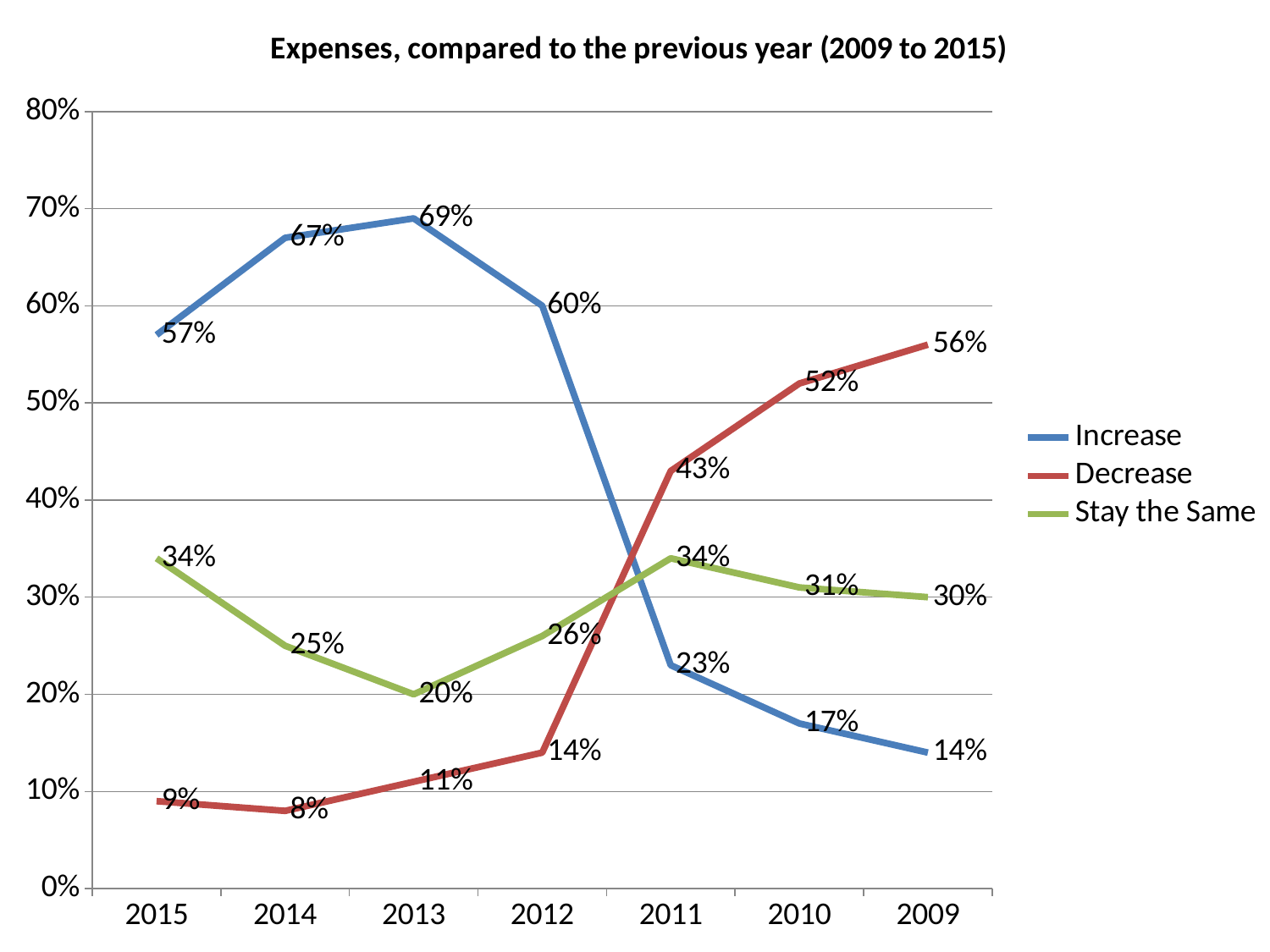
What is the value for Increase in 2013? 69% How many series does the legend list? 3 How many years are shown on the x axis? 7 What is the title of the chart? Expenses, compared to the previous year (2009 to 2015) In which year is the Decrease series lowest? 2014 In which year is the Increase series highest? 2013 Does the Decrease series rise or fall moving from 2015 to 2009 along the x axis? Rise Which is larger in 2010: Decrease or Stay the Same? Decrease What is the value for Stay the Same in 2012? 26% What is the difference between the Increase value in 2012 and the Increase value in 2011? 37% What kind of chart is this? Line chart What is the value for Decrease in 2009? 56%